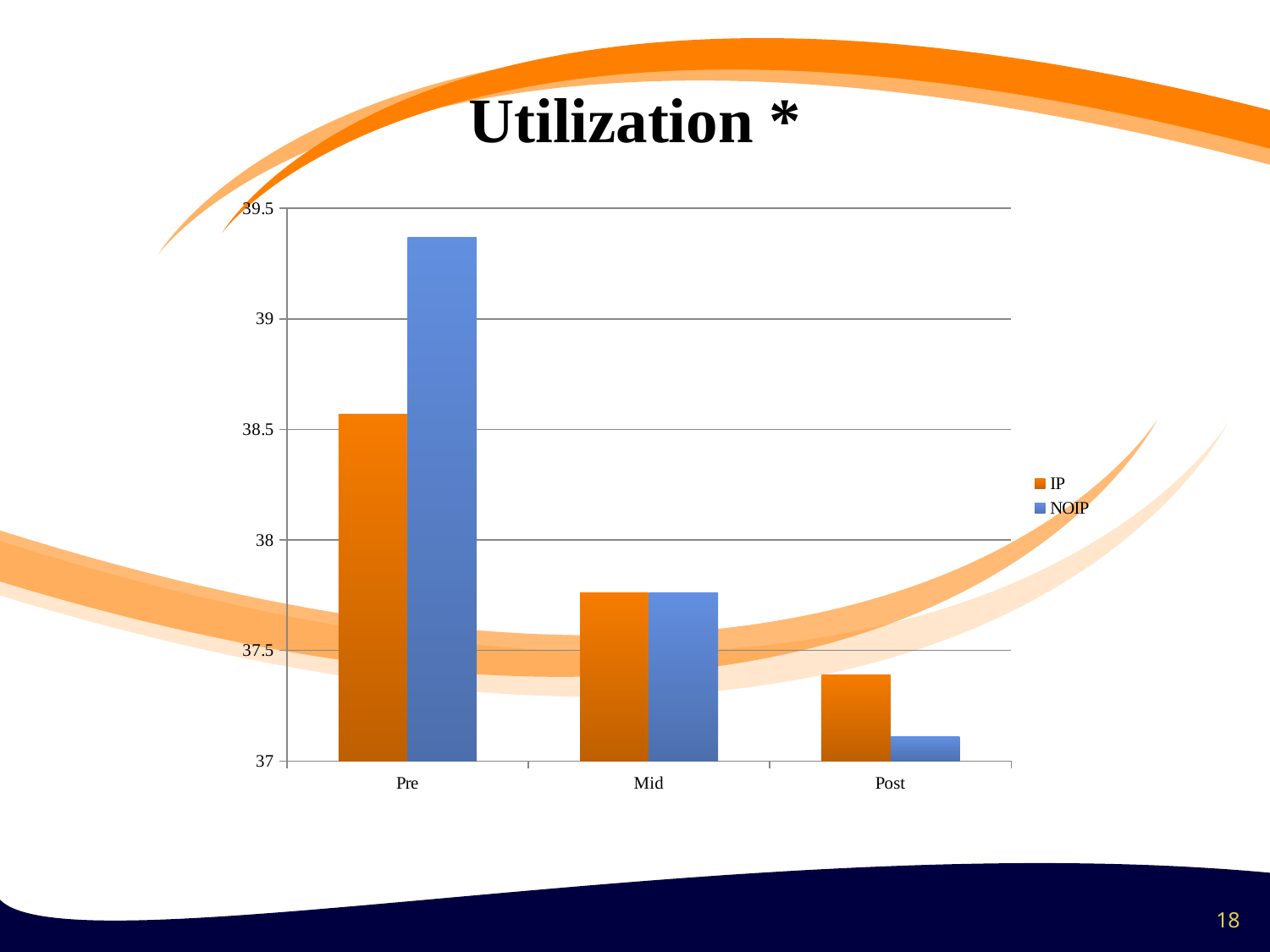
Do the IP values rise or fall from Pre to Post? fall How many series does the legend list? 2 For the Post category, which series has the larger value, IP or NOIP? IP Which category has the highest NOIP value? Pre Which category has the lowest IP value? Post What is the title of the chart? Utilization * How many categories are shown on the x axis? 3 Is the NOIP value for Pre greater or less than 39? greater For the Pre category, which series has the larger value, IP or NOIP? NOIP What kind of chart is shown on the slide? bar chart Is the IP value for Mid greater or less than 38? less Which category has the lowest NOIP value? Post